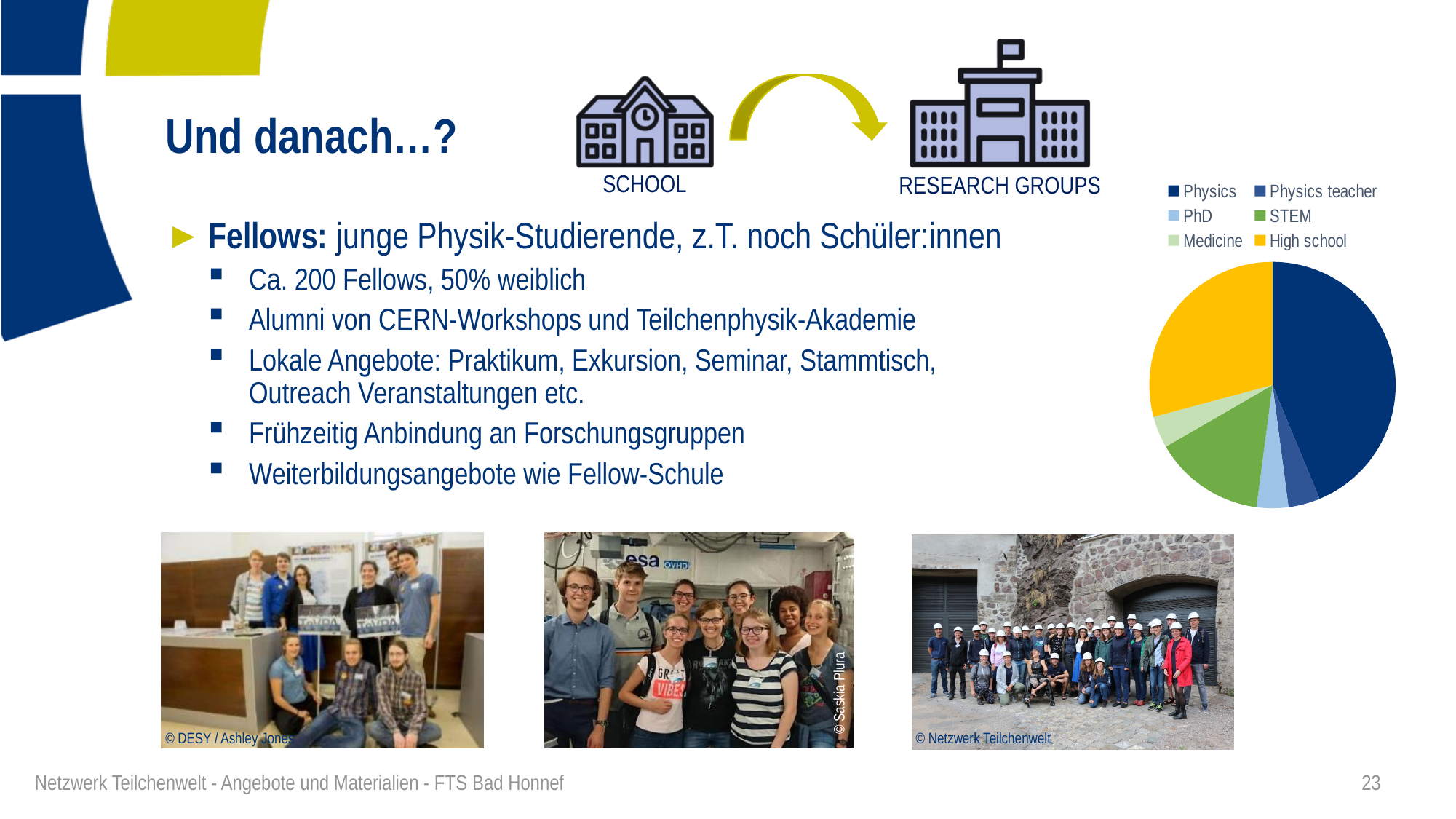
In the pie chart, which slice is larger: High school or Medicine? High school In the pie chart, which slice is larger: Physics or High school? Physics In the pie chart, which slice is larger: High school or STEM? High school Which category in the pie chart is shown in dark blue? Physics Which category has the largest slice in the pie chart? Physics Which category in the pie chart is shown in yellow? High school What kind of chart is shown on the right side of the slide? pie chart How many categories does the legend of the pie chart list? 6